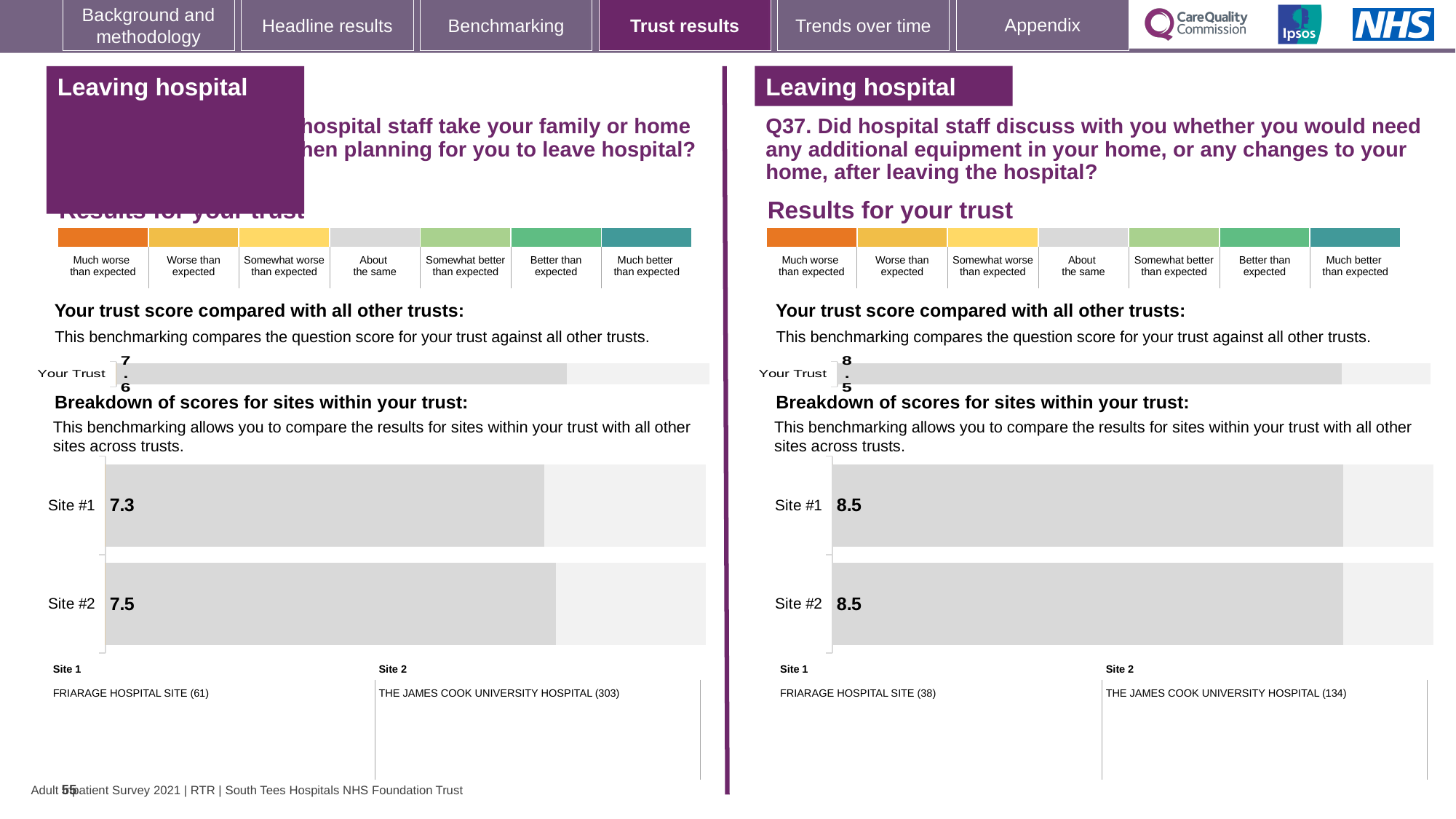
On the right-hand side of the slide (Q37), what is the score shown for Site #1 in the breakdown of scores for sites within your trust? 8.5 On the left-hand side of the slide, what is the score shown for Site #1 in the breakdown of scores for sites within your trust? 7.3 On the right-hand side of the slide (Q37), what is the score shown for Site #2 in the breakdown of scores for sites within your trust? 8.5 In the right-hand (Q37) site breakdown chart, what is the difference between the Site #1 score and the Site #2 score? 0 On the right-hand side of the slide (Q37), what is the 'Your Trust' score in the trust score comparison chart? 8.5 On the left-hand side of the slide, what is the 'Your Trust' score in the trust score comparison chart? 7.6 In the left-hand site breakdown chart, which site has the higher score, Site #1 or Site #2? Site #2 What type of chart is used for the breakdown of scores for sites within your trust on the right-hand side of the slide? Bar chart In the left-hand site breakdown chart, what is the difference between the Site #2 score and the Site #1 score? 0.2 On the left-hand side of the slide, what is the score shown for Site #2 in the breakdown of scores for sites within your trust? 7.5 In the site breakdown charts, which hospital is listed as Site 2? The James Cook University Hospital How many sites are shown in the left-hand breakdown of scores for sites within your trust chart? 2